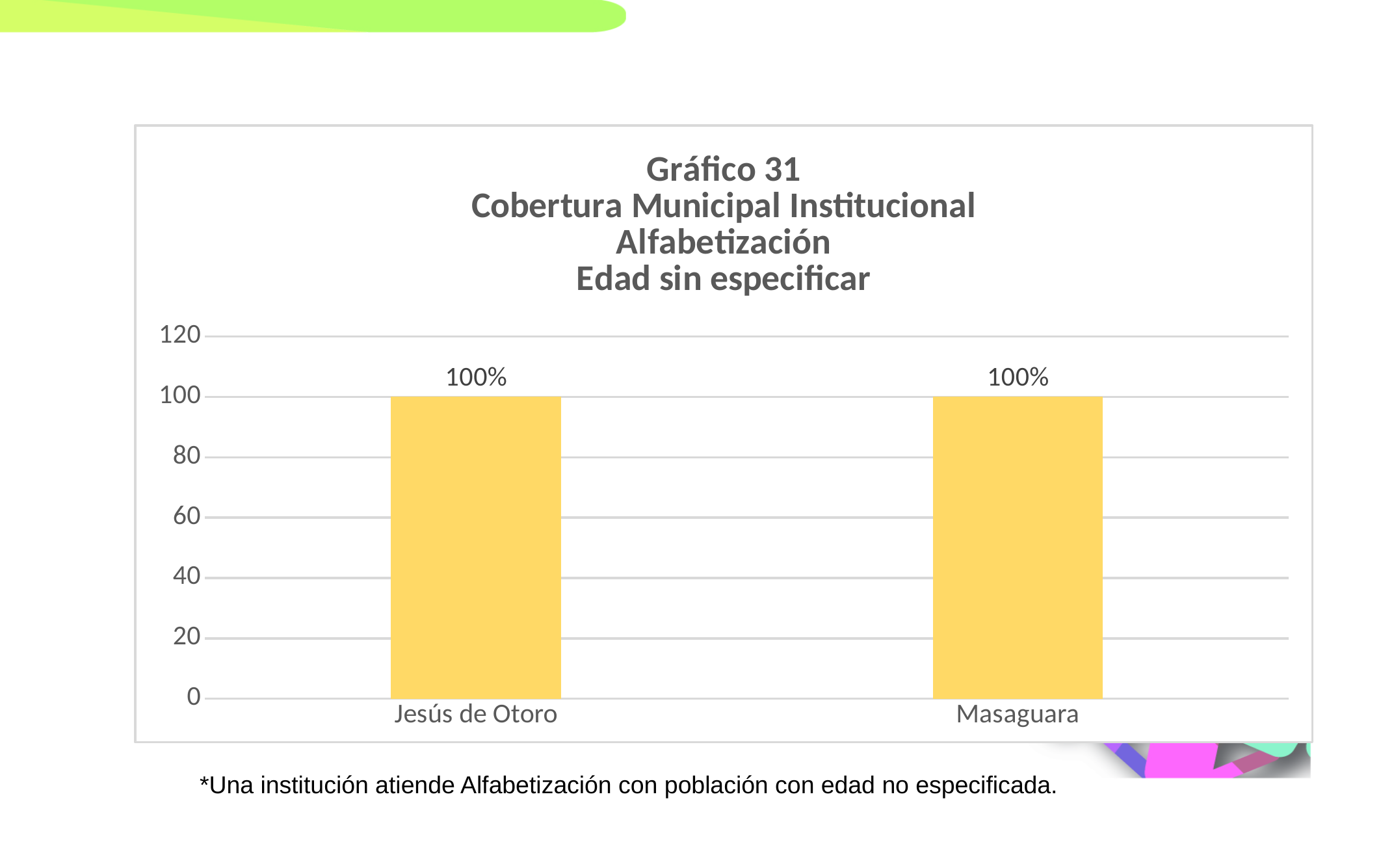
Do the values for Jesús de Otoro and Masaguara differ? No, both are 100% What is the value for Jesús de Otoro? 100% What is the highest value shown on the y axis? 120 What is the value for Masaguara? 100% What is the chart number given in the title? Gráfico 31 What kind of chart is this? bar chart Is the value for Masaguara greater or less than 80? greater What is the difference between the values for Jesús de Otoro and Masaguara? 0 How many categories are shown on the x axis? 2 Is the value for Jesús de Otoro greater or less than 120? less